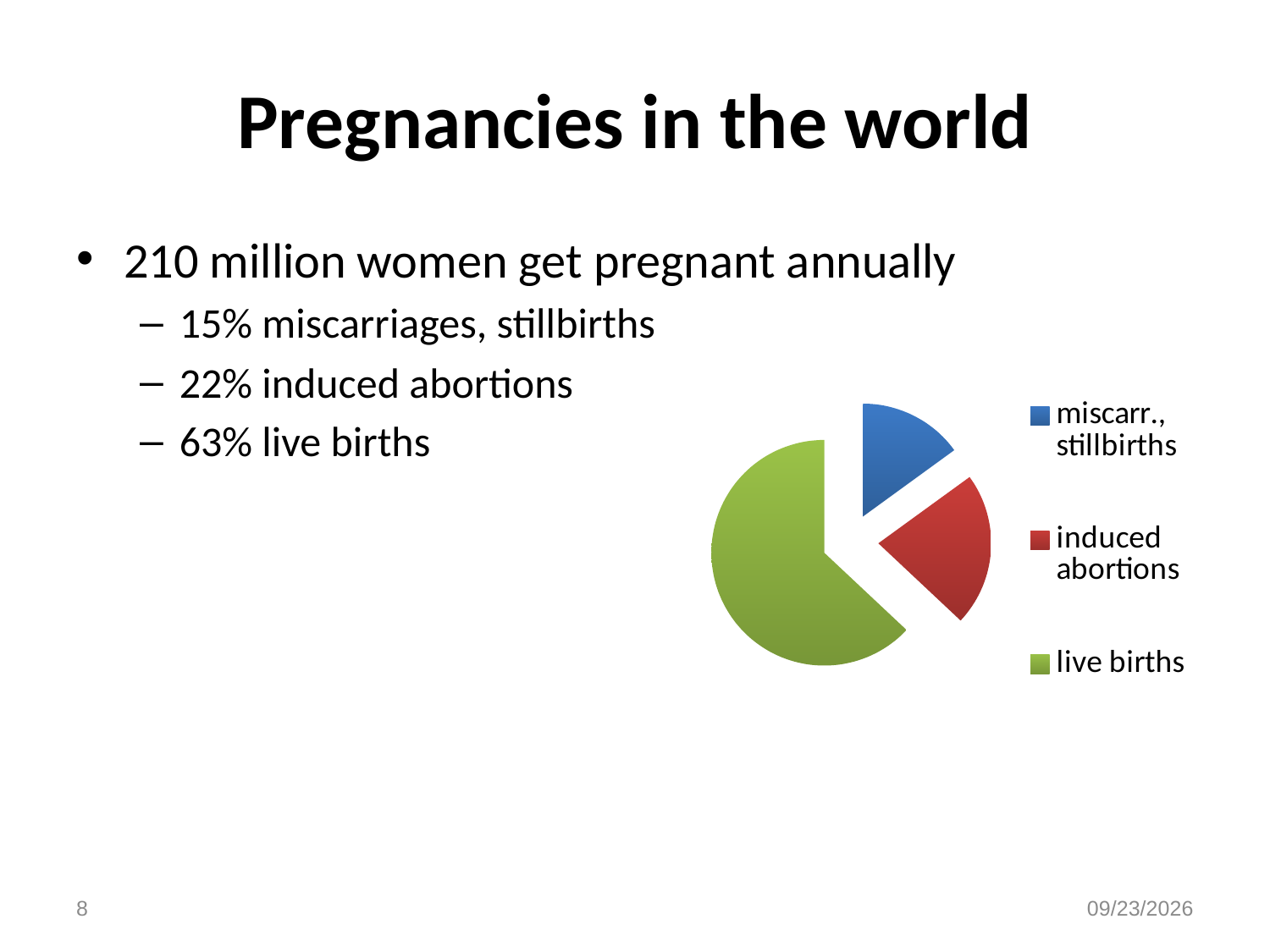
How many slices does the pie chart have? 3 What colour is the miscarr., stillbirths slice in the pie chart? blue According to the slide, what share of pregnancies are induced abortions? 22% Which category has the largest slice in the pie chart? live births Does the live births slice take up more or less than half of the pie chart? more What colour is the live births slice in the pie chart? green What kind of chart is shown on the slide? pie chart Which category has the smallest slice in the pie chart? miscarr., stillbirths Which slice is larger in the pie chart: induced abortions or miscarr., stillbirths? induced abortions According to the slide, what share of pregnancies are miscarriages and stillbirths? 15% According to the slide, what share of pregnancies are live births? 63% How many entries does the legend of the pie chart list? 3